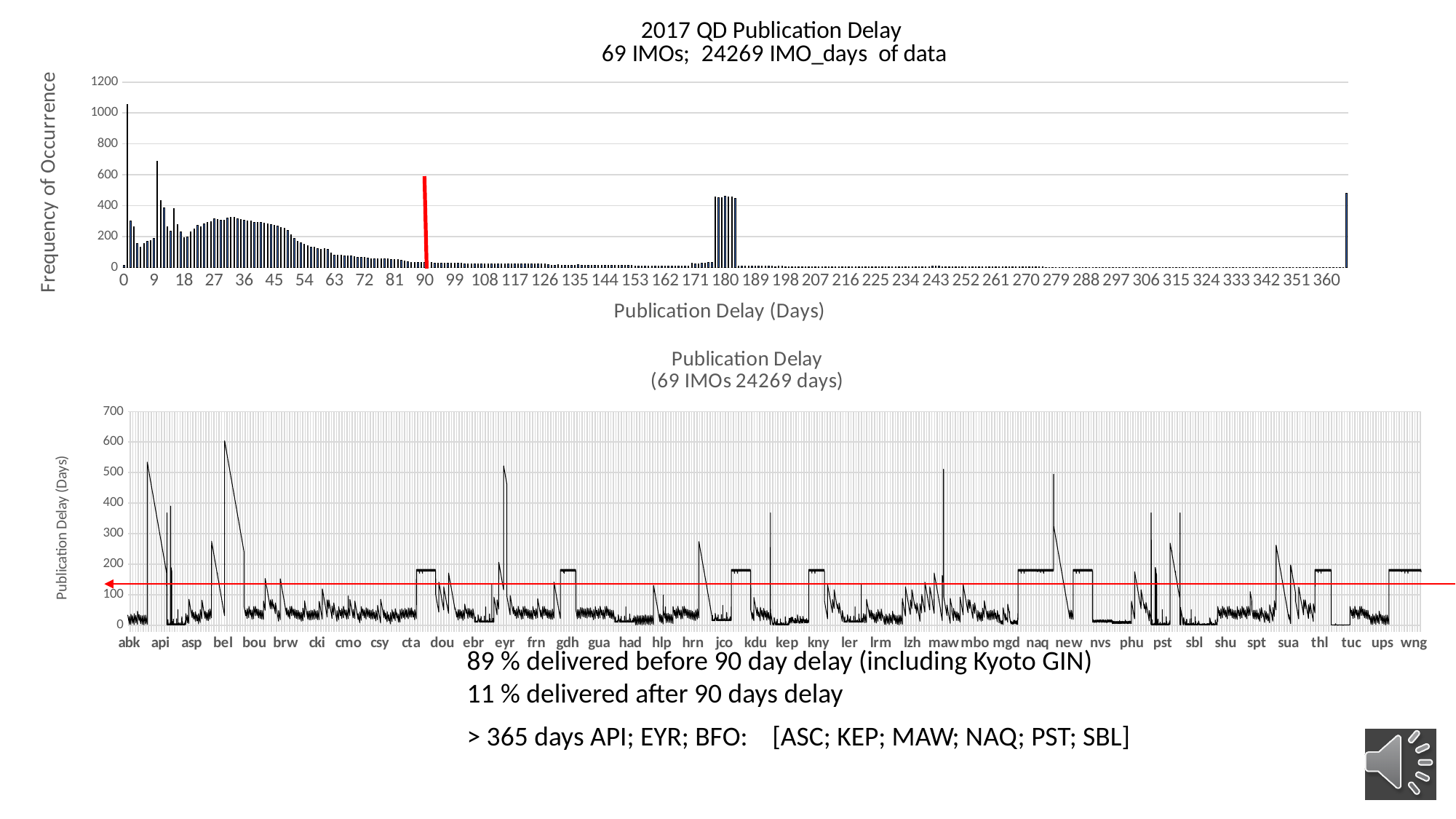
In the top chart, are the tall bars just before 180 days greater or less than 400? greater What kind of chart is the bottom chart titled 'Publication Delay (69 IMOs 24269 days)'? line chart In the bottom chart, is the peak publication delay near 'bel' greater or less than 500? greater What kind of chart is the top chart titled '2017 QD Publication Delay'? bar chart In the top chart, what is the title of the vertical axis? Frequency of Occurrence In the top chart, is the bar at the far right end (beyond 360 days) greater or less than 400? greater In the top chart, what is the title of the horizontal axis? Publication Delay (Days)